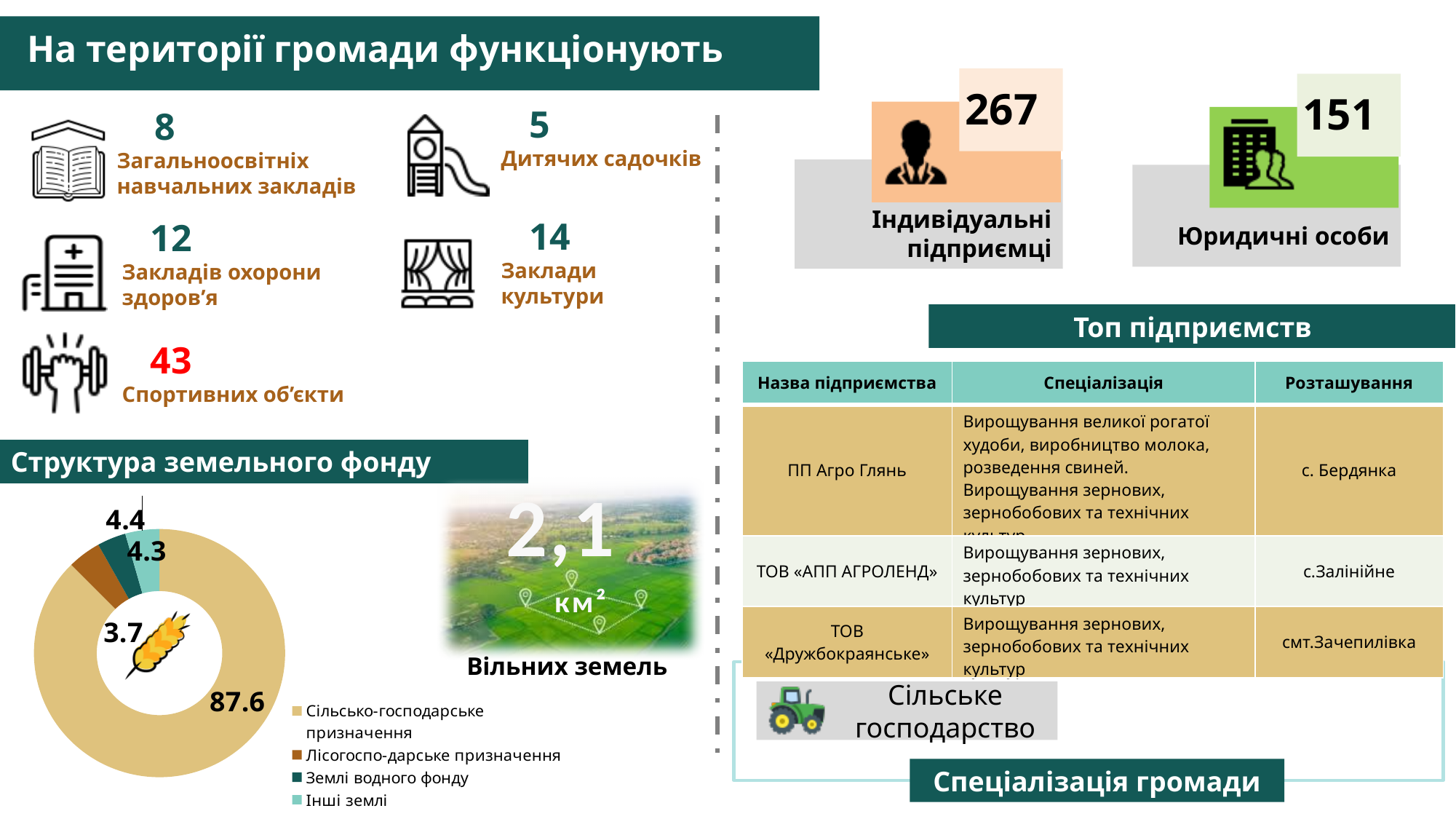
In the 'Структура земельного фонду' chart, which category has the largest share? Сільсько-господарське призначення What type of chart is shown under 'Структура земельного фонду'? Doughnut (pie) chart In the 'Структура земельного фонду' chart, what is the difference between 'Сільсько-господарське призначення' and 'Лісогоспо-дарське призначення'? 83.3 In the 'Структура земельного фонду' chart, what is the combined value of 'Землі водного фонду' and 'Інші землі'? 8.1 How many categories does the 'Структура земельного фонду' chart show? 4 In the 'Структура земельного фонду' chart, which category has the smallest share? Землі водного фонду In the 'Структура земельного фонду' chart, what is the value for 'Лісогоспо-дарське призначення'? 4.3 In the 'Структура земельного фонду' chart, what is the value for 'Інші землі'? 4.4 In the 'Структура земельного фонду' chart, which is larger: 'Землі водного фонду' or 'Лісогоспо-дарське призначення'? Лісогоспо-дарське призначення In the 'Структура земельного фонду' chart, what is the value for 'Землі водного фонду'? 3.7 What colour represents 'Сільсько-господарське призначення' in the 'Структура земельного фонду' chart? Tan (light brown) In the 'Структура земельного фонду' chart, what is the value for 'Сільсько-господарське призначення'? 87.6